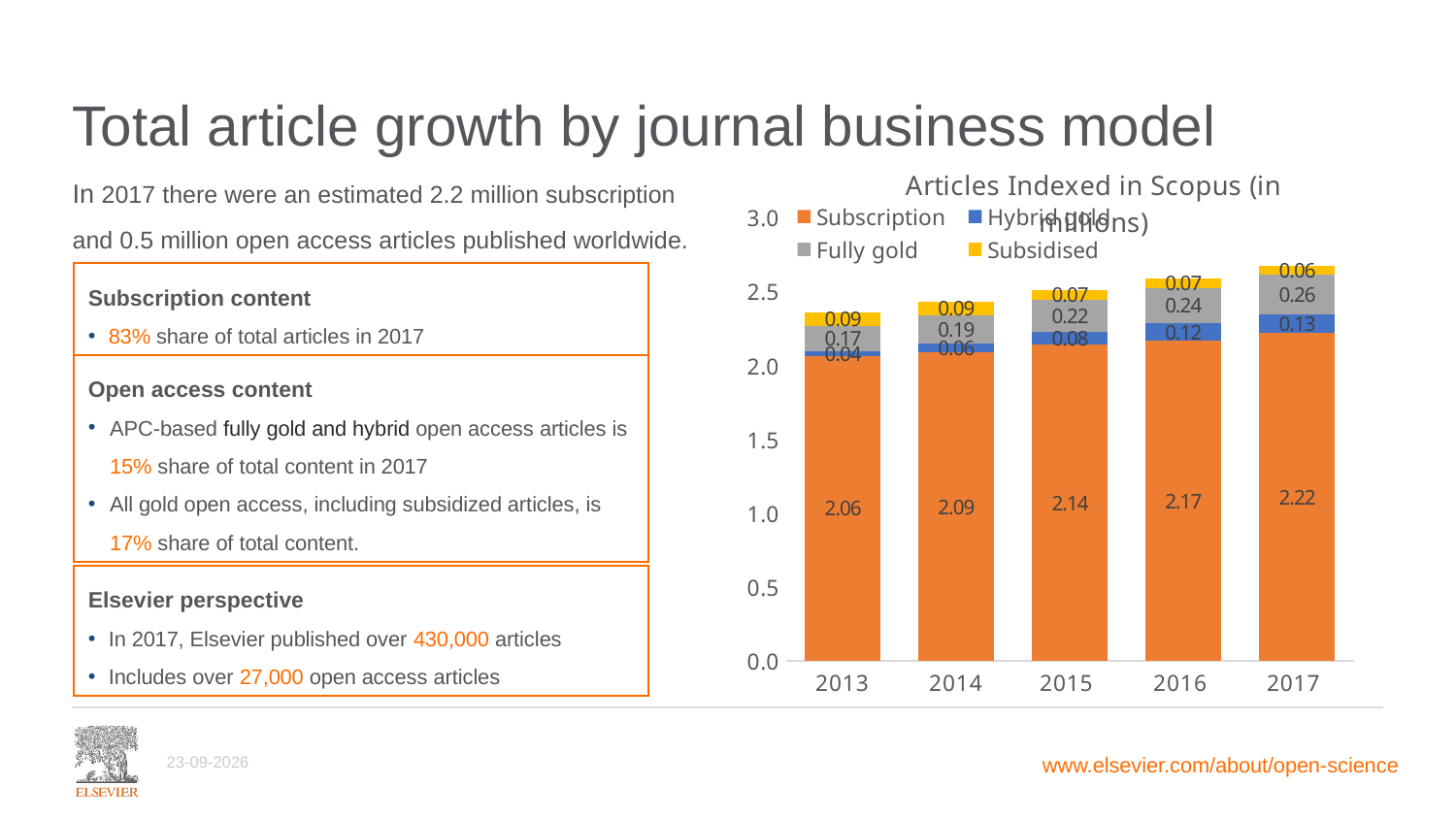
Which year has the highest Subscription value? 2017 What kind of chart is shown on the slide? stacked bar chart What is the Subscription value for 2017? 2.22 What is the total of the stacked bar for 2013? 2.36 How many years are shown on the x axis? 5 How many series does the legend list? 4 Which is larger, the Fully gold value for 2016 or the Fully gold value for 2014? 2016 What is the Fully gold value for 2015? 0.22 What is the difference between the Subscription values for 2017 and 2013? 0.16 Which year has the lowest Hybrid gold value? 2013 Is the total height of the 2017 stacked bar greater or less than 2.5? greater What is the Hybrid gold value for 2013? 0.04